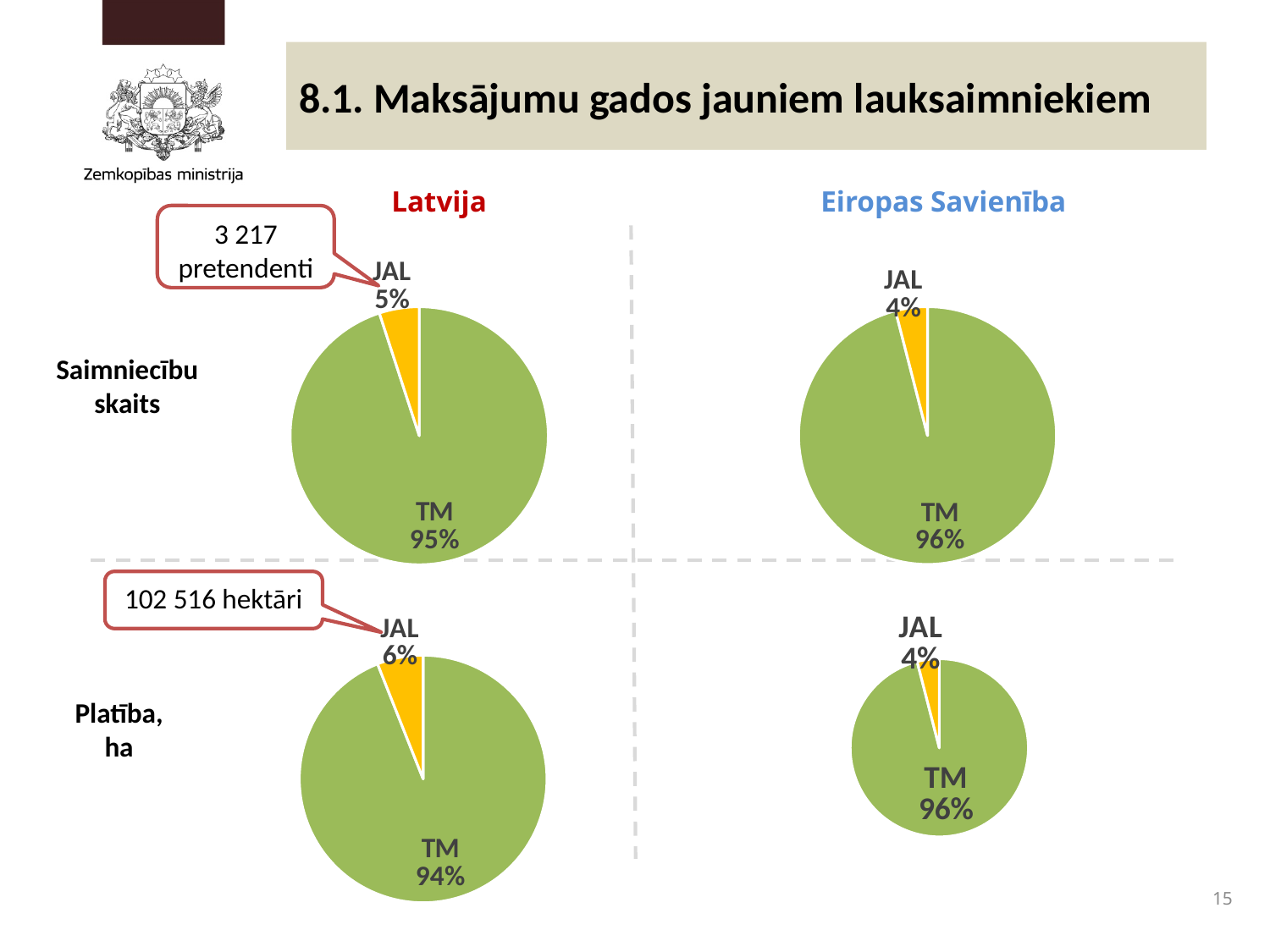
What kind of chart is used for the Latvija Saimniecību skaits data? Pie chart In the bottom-left pie chart (Latvija, Platība, ha), what share does JAL have? 6% Is the JAL share in the bottom-left pie chart (Latvija, Platība, ha) larger or smaller than the JAL share in the bottom-right pie chart (Eiropas Savienība, Platība, ha)? Larger In the top-right pie chart (Eiropas Savienība, Saimniecību skaits), what share does JAL have? 4% In the bottom-right pie chart (Eiropas Savienība, Platība, ha), what share does TM have? 96% What is the difference between the TM share in the top-left pie chart (Latvija, Saimniecību skaits) and the TM share in the top-right pie chart (Eiropas Savienība, Saimniecību skaits)? 1% In the top-left pie chart (Latvija, Saimniecību skaits), which slice is the largest? TM How many slices does the top-right pie chart (Eiropas Savienība, Saimniecību skaits) have? 2 In the top-left pie chart (Latvija, Saimniecību skaits), what share does JAL have? 5% In the bottom-left pie chart (Latvija, Platība, ha), what share does TM have? 94% In the top-left pie chart (Latvija, Saimniecību skaits), what share does TM have? 95% In the bottom-left pie chart (Latvija, Platība, ha), which slice is the smallest? JAL